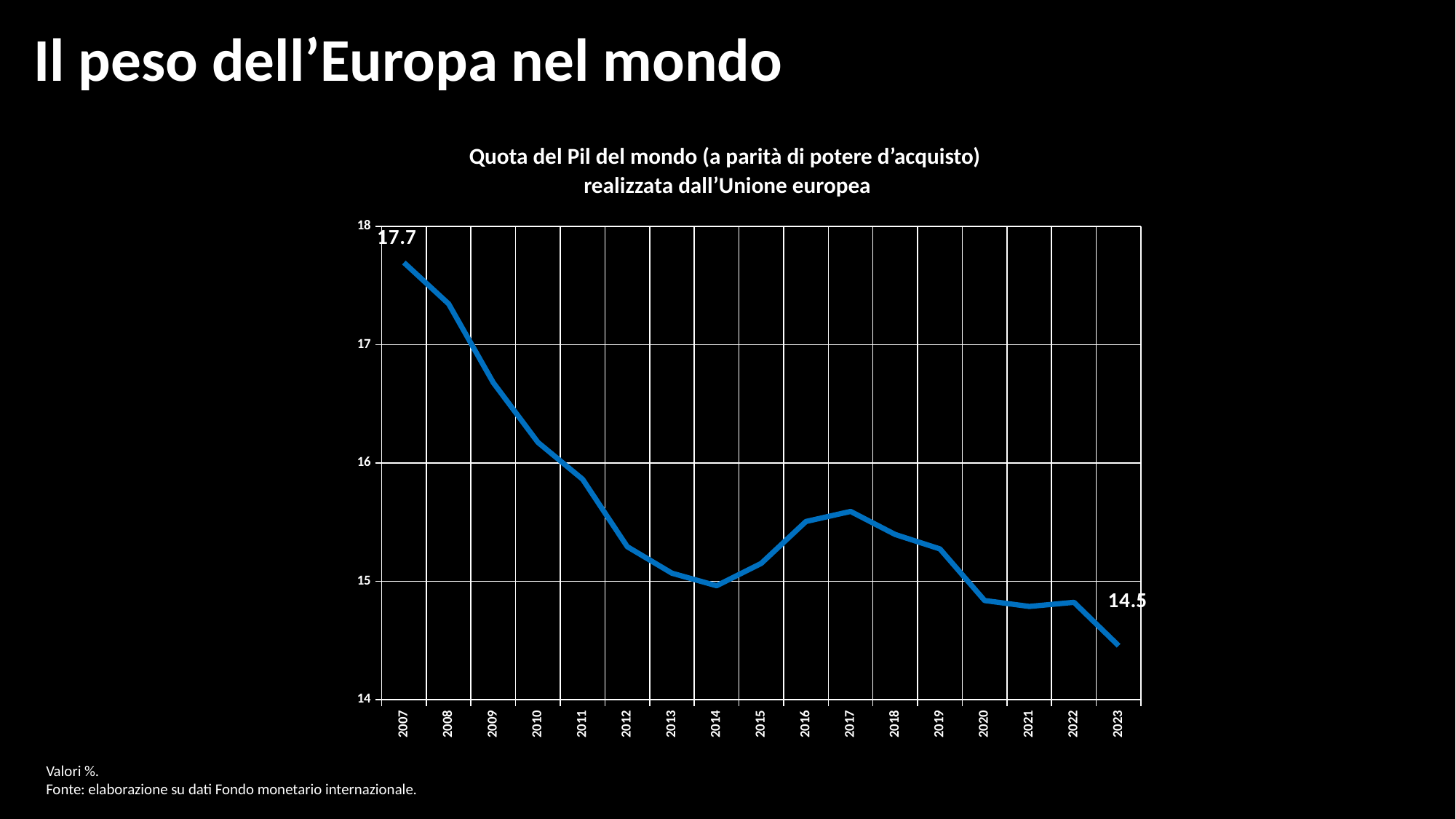
What is the value for 2007? 17.7 Which year has the highest value? 2007 What is the difference between the values for 2007 and 2023? 3.2 How many years are plotted on the x axis? 17 What kind of chart is shown? line chart Which is larger, the value for 2017 or the value for 2014? 2017 Is the value for 2017 greater or less than 15? greater What is the value for 2023? 14.5 Is the value for 2009 greater or less than 16? greater Is the value for 2014 greater or less than 16? less Do the values generally rise or fall from 2007 to 2023? fall Which year has the lowest value? 2023